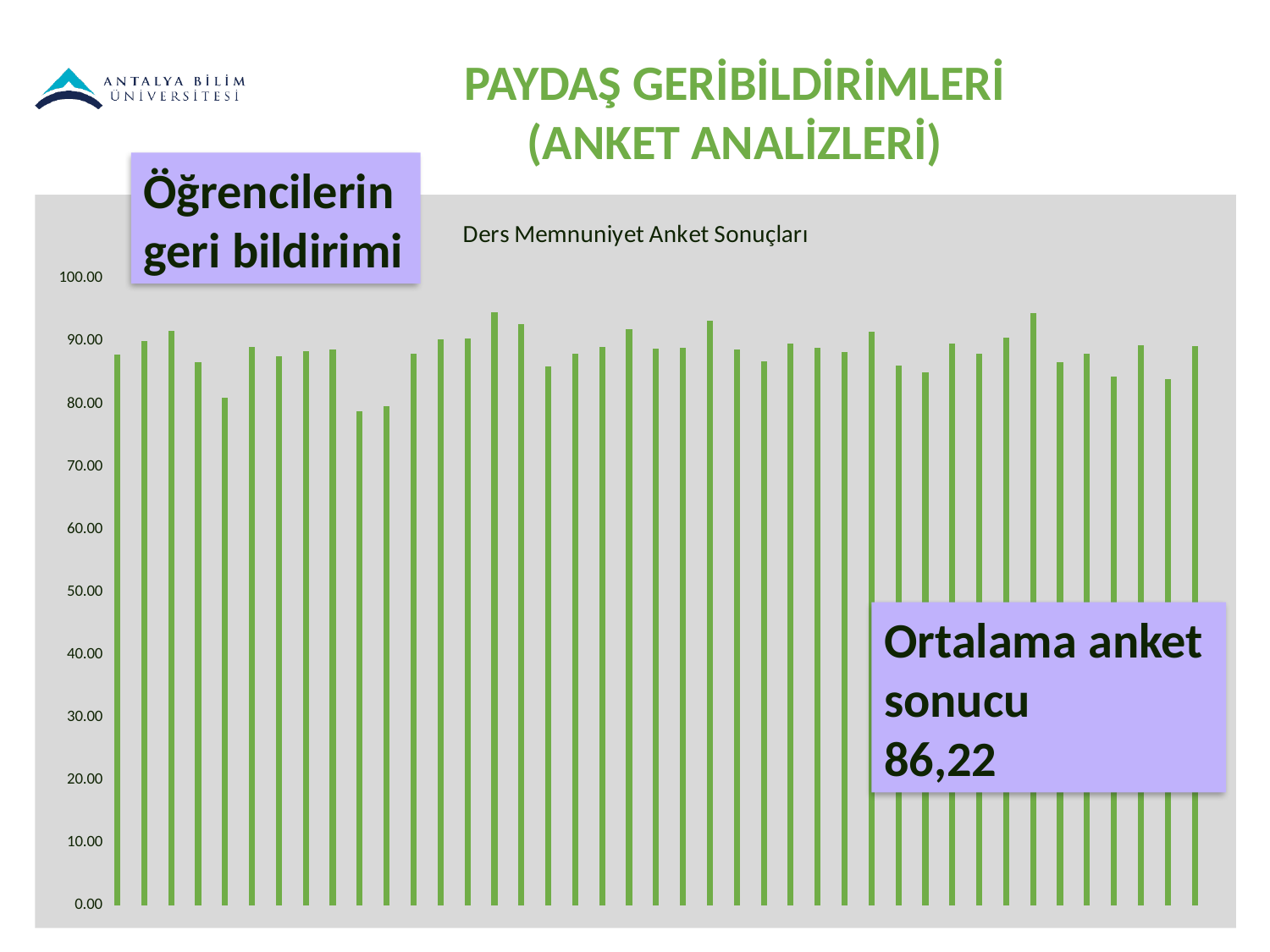
What kind of chart is shown on the slide? bar chart What average survey result (Ortalama anket sonucu) is stated on the slide? 86,22 Is the last (rightmost) bar greater or less than 80? greater Is the first (leftmost) bar greater or less than 80? greater What is the highest value shown on the vertical axis? 100.00 Is the tallest bar in the chart greater or less than 100? less What is the title of the chart? Ders Memnuniyet Anket Sonuçları